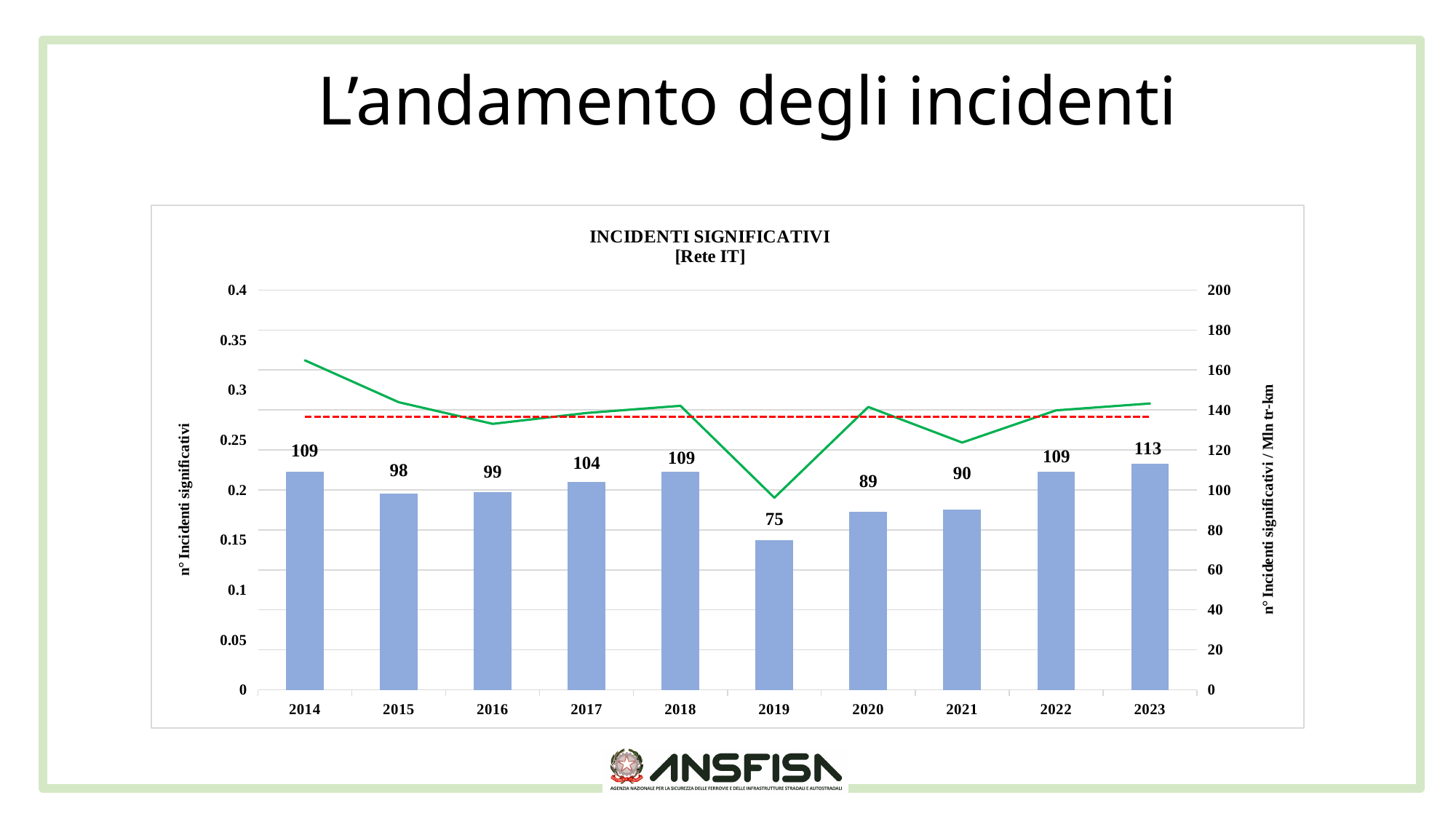
Which year has the lowest bar value? 2019 What is the bar value for 2023? 113 Which year has a larger bar value, 2020 or 2021? 2021 Is the value of the green line for 2014 greater or less than 0.3 on the left axis? greater How many years are shown on the x axis? 10 What is the bar value for 2017? 104 What is the number of significant incidents (bar value) for 2019? 75 Is the value of the green line for 2019 greater or less than 0.2 on the left axis? less What is the title of the chart? INCIDENTI SIGNIFICATIVI [Rete IT] Do the bar values rise or fall from 2019 to 2023? rise Which year has the highest bar value? 2023 What is the difference between the bar values for 2023 and 2019? 38